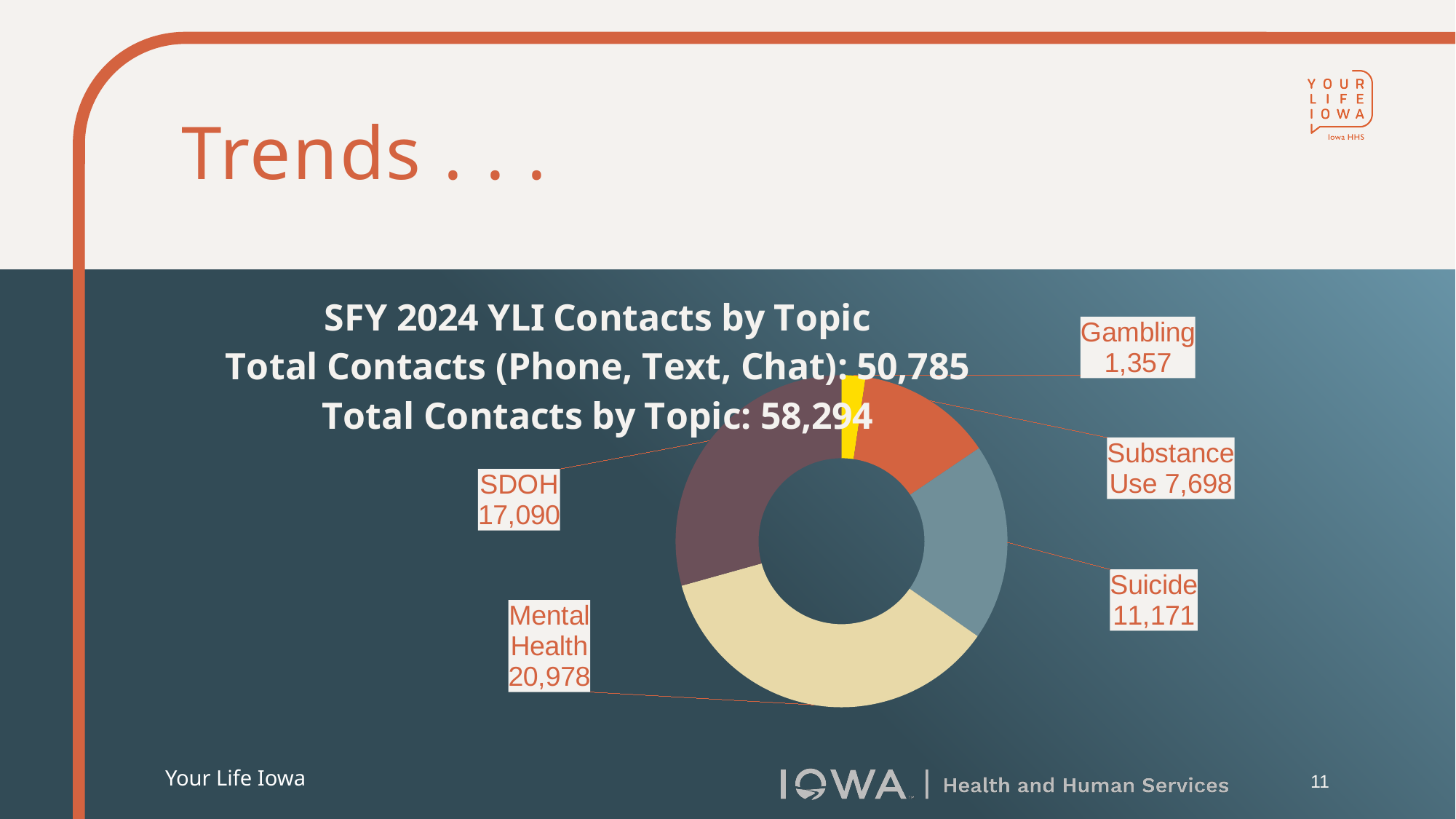
What kind of chart is shown on the slide? Doughnut (pie) chart What is the number of contacts for SDOH? 17,090 What is the difference in contacts between Mental Health and SDOH? 3,888 What is the total number of contacts by topic shown on the slide? 58,294 What is the number of contacts for Substance Use? 7,698 How many topic categories does the chart show? 5 Which has more contacts, Suicide or Substance Use? Suicide What is the number of contacts for Mental Health? 20,978 Which topic has the lowest number of contacts? Gambling Which topic has the highest number of contacts? Mental Health What is the title of the chart? SFY 2024 YLI Contacts by Topic What is the number of contacts for Gambling? 1,357